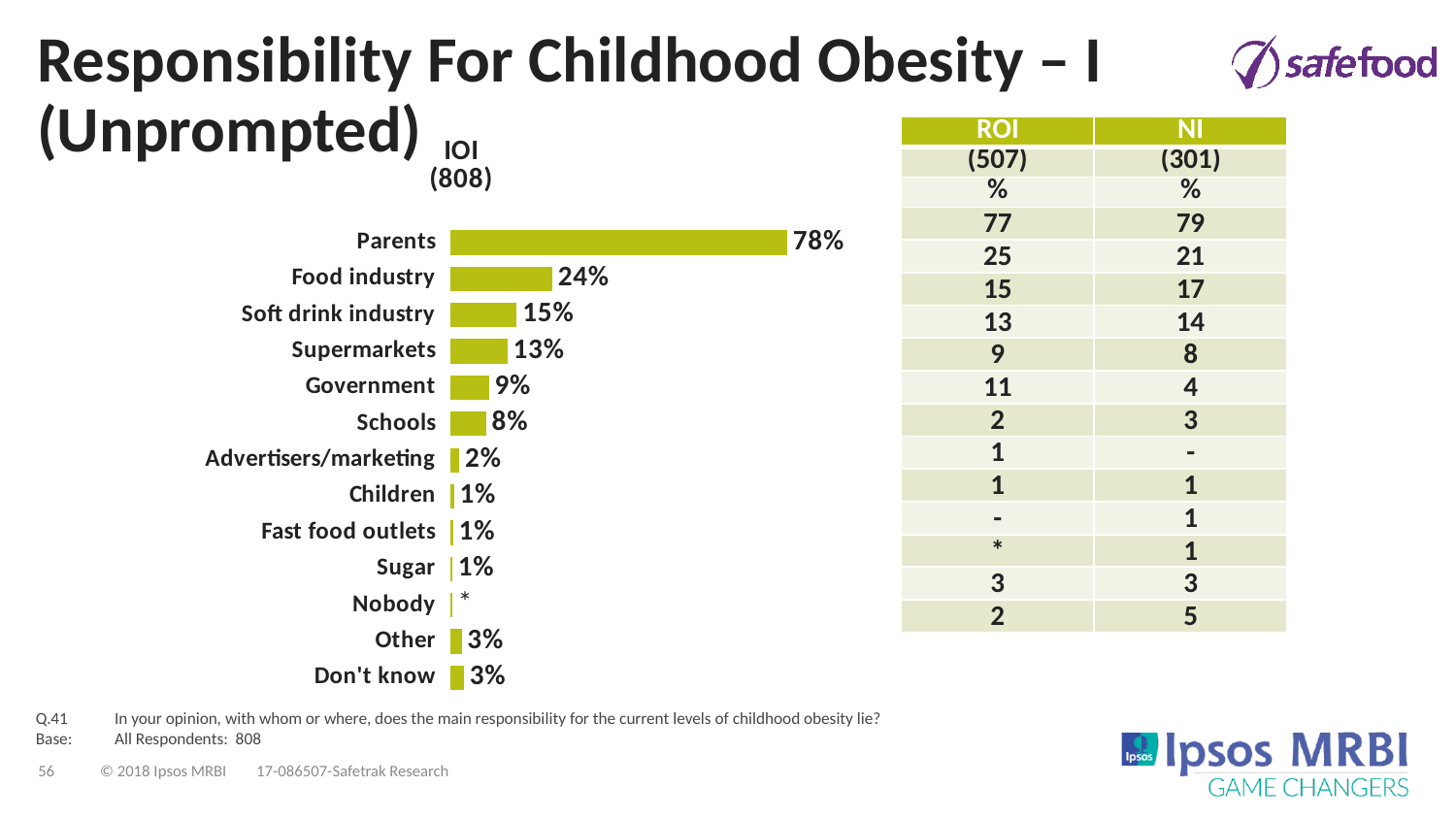
What is the difference between the values for Parents and Food industry? 54 percentage points What kind of chart is shown on the slide? Bar chart What percentage of respondents said Parents are responsible for childhood obesity? 78% Which is larger, the value for Supermarkets or the value for Government? Supermarkets What is the value shown for Food industry in the bar chart? 24% What value does the bar chart show for Don't know? 3% Which category has the highest value in the bar chart? Parents How many categories are plotted in the bar chart? 13 Which is larger, the value for Soft drink industry or the value for Schools? Soft drink industry What is the difference between the values for Soft drink industry and Supermarkets? 2 percentage points What is the base size shown above the bar chart for IOI? 808 What percentage is shown for Government? 9%